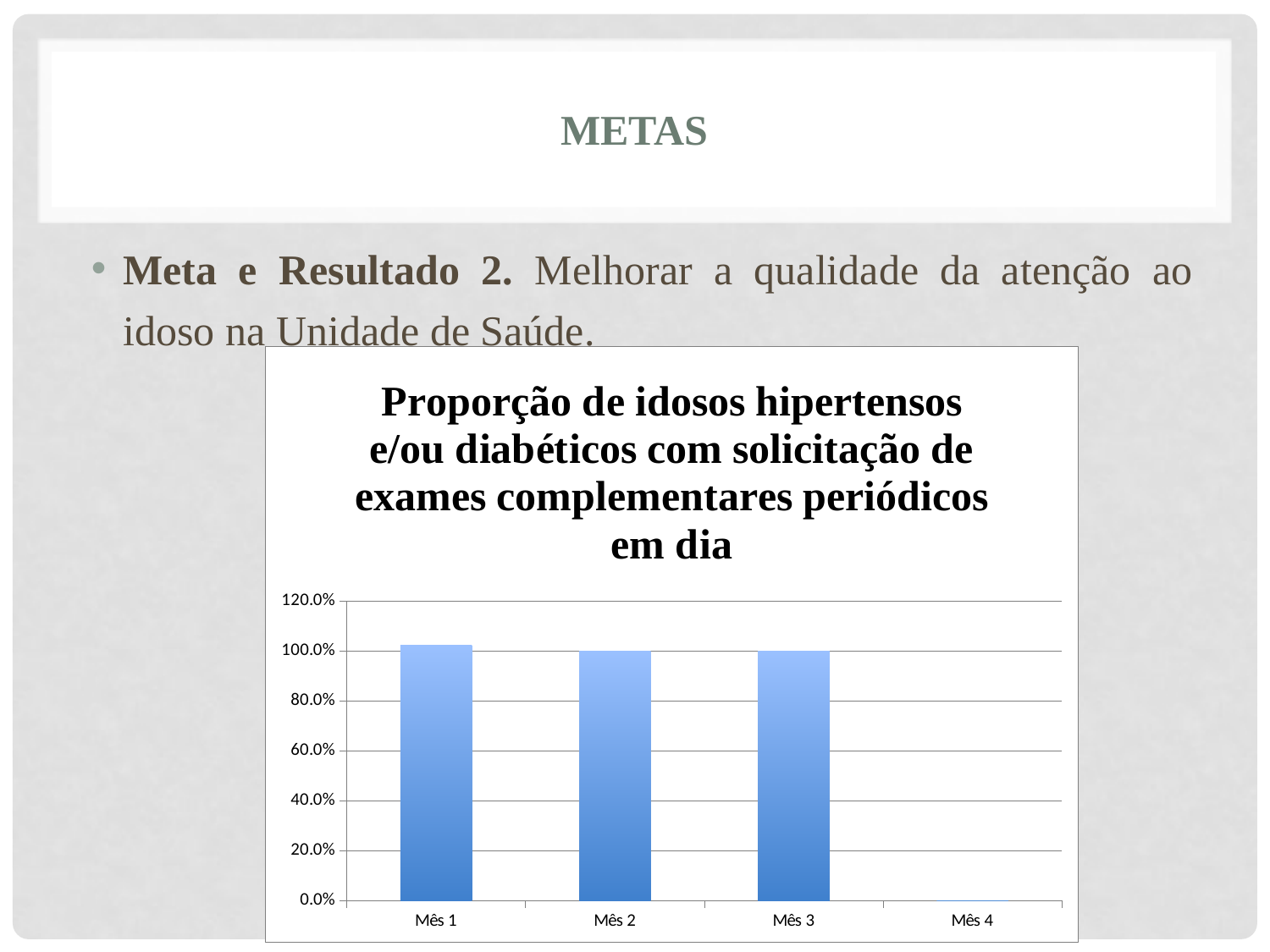
What is the highest value shown on the chart's y axis? 120.0% What kind of chart is shown on the slide? bar chart Which month has the highest value in the chart? Mês 1 Which is larger, the value for Mês 1 or the value for Mês 4? Mês 1 Is the value for Mês 1 greater or less than 80.0%? greater Do the values rise or fall from Mês 1 to Mês 4? fall What is the title of the chart? Proporção de idosos hipertensos e/ou diabéticos com solicitação de exames complementares periódicos em dia How many months (categories) are shown on the x axis of the chart? 4 Which month has the lowest value in the chart? Mês 4 Is the value for Mês 4 greater or less than 20.0%? less Which is larger, the value for Mês 2 or the value for Mês 4? Mês 2 Is the value for Mês 3 greater or less than 60.0%? greater